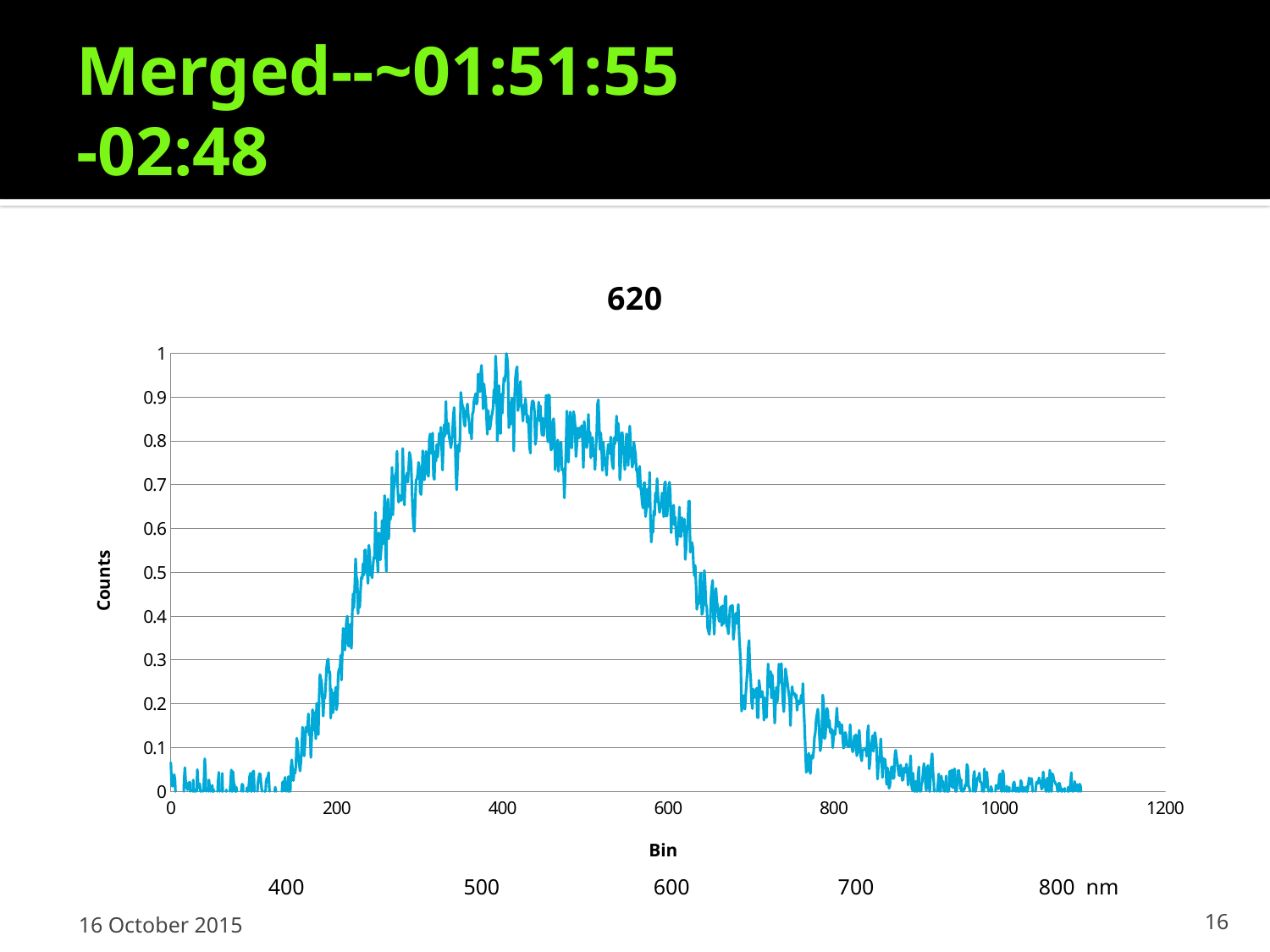
Which is larger, the value at bin 400 or the value at bin 800? bin 400 Do the values rise or fall along the x axis between bin 200 and bin 400? rise What is the label of the y axis? Counts What kind of chart is shown on the slide? line chart Which is larger, the value at bin 100 or the value at bin 500? bin 500 Is the value at bin 400 greater or less than 0.5? greater Is the value at bin 200 greater or less than 0.5? less Do the values rise or fall along the x axis between bin 600 and bin 800? fall Is the value at bin 600 greater or less than 0.4? greater What is the title of the chart? 620